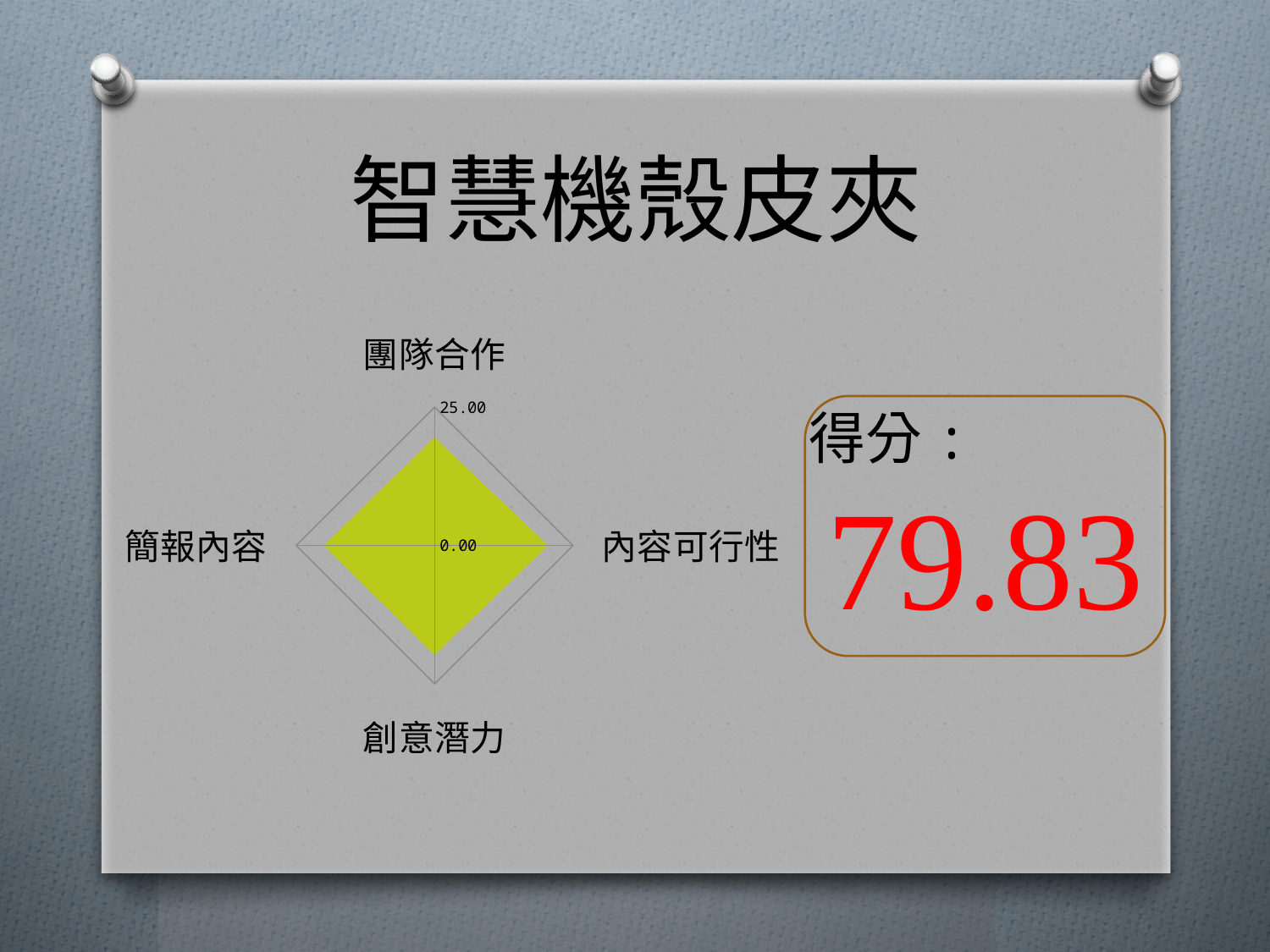
Which category label appears at the top of the radar chart? 團隊合作 What kind of chart is shown on the slide? Radar chart How many categories (axes) does the radar chart have? 4 What is the minimum value shown on the radar chart's axis scale? 0.00 Is the value for 創意潛力 greater or less than 25.00? less Which category label appears at the bottom of the radar chart? 創意潛力 Is the value for 簡報內容 greater or less than 25.00? less Is the value for 內容可行性 greater or less than 25.00? less